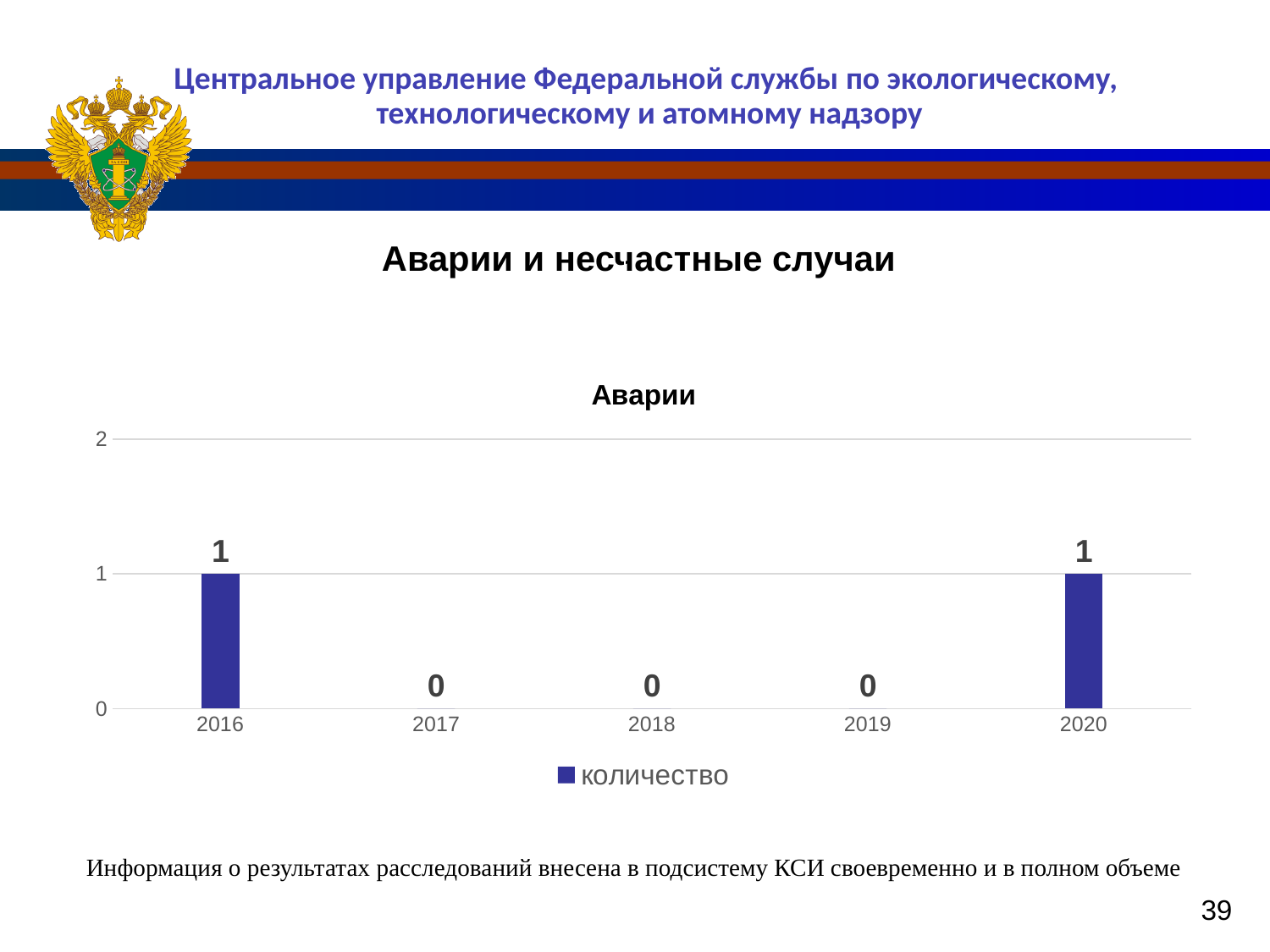
What is the name of the series in the legend? количество How many years are shown on the x axis of the chart? 5 What is the value for 2018 in the Аварии chart? 0 How many series does the legend list? 1 What is the value for 2019 in the Аварии chart? 0 Which is larger, the value for 2020 or the value for 2019? 2020 What is the value for 2016 in the Аварии chart? 1 What kind of chart is shown on the slide? bar chart What is the value for 2020 in the Аварии chart? 1 What is the difference between the values for 2016 and 2017? 1 Is the value for 2016 greater or less than 2? less What is the title of the chart? Аварии